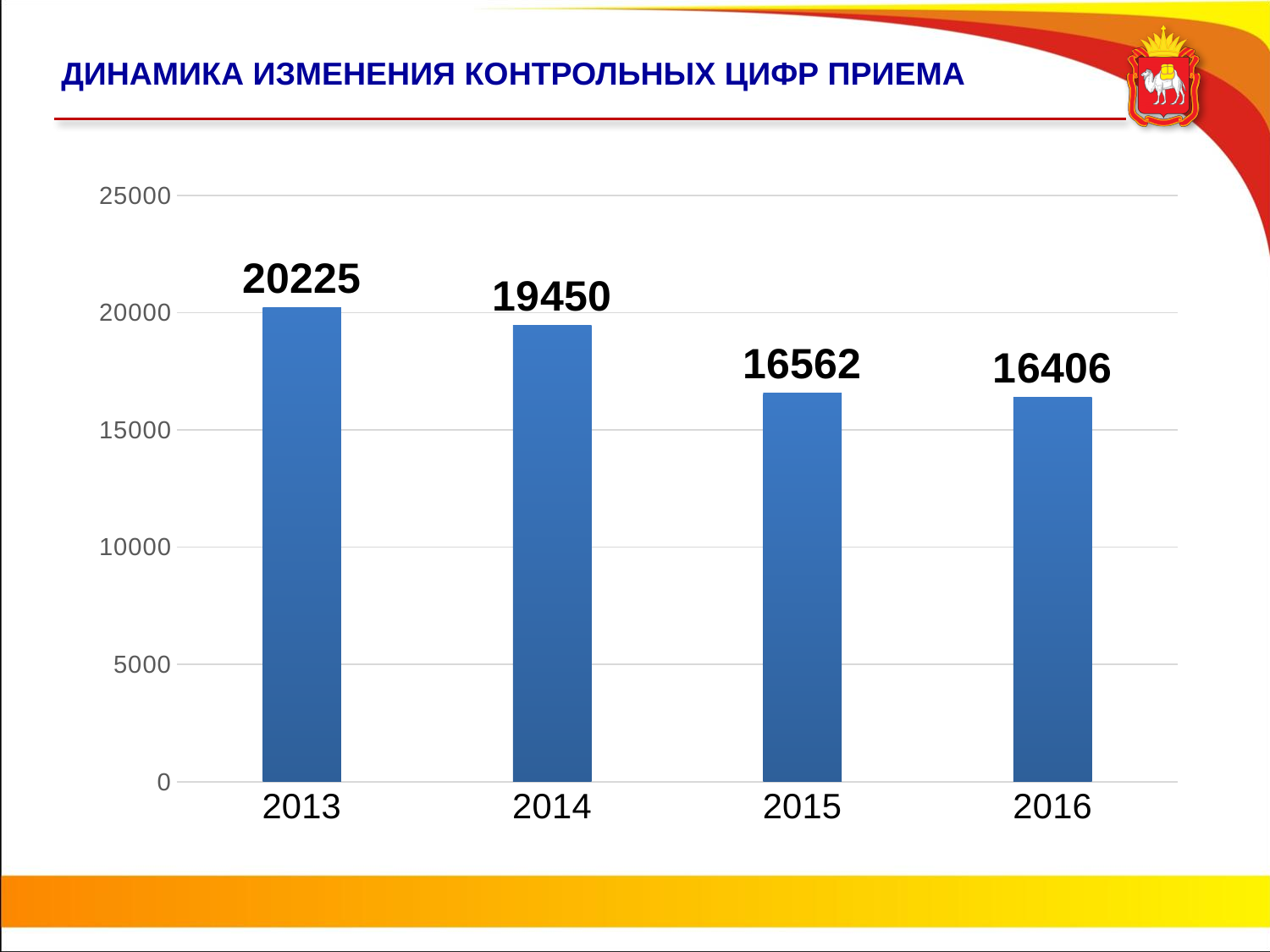
Which year has the lowest value? 2016 What is the value for 2015? 16562 Which is larger, the value for 2014 or the value for 2015? 2014 What is the value for 2014? 19450 Do the values rise or fall from 2013 to 2016? fall What is the difference between the values for 2013 and 2014? 775 How many years are shown on the chart? 4 What is the value for 2013? 20225 What is the difference between the values for 2015 and 2016? 156 Which year has the highest value? 2013 What kind of chart is shown on the slide? bar chart What is the value for 2016? 16406